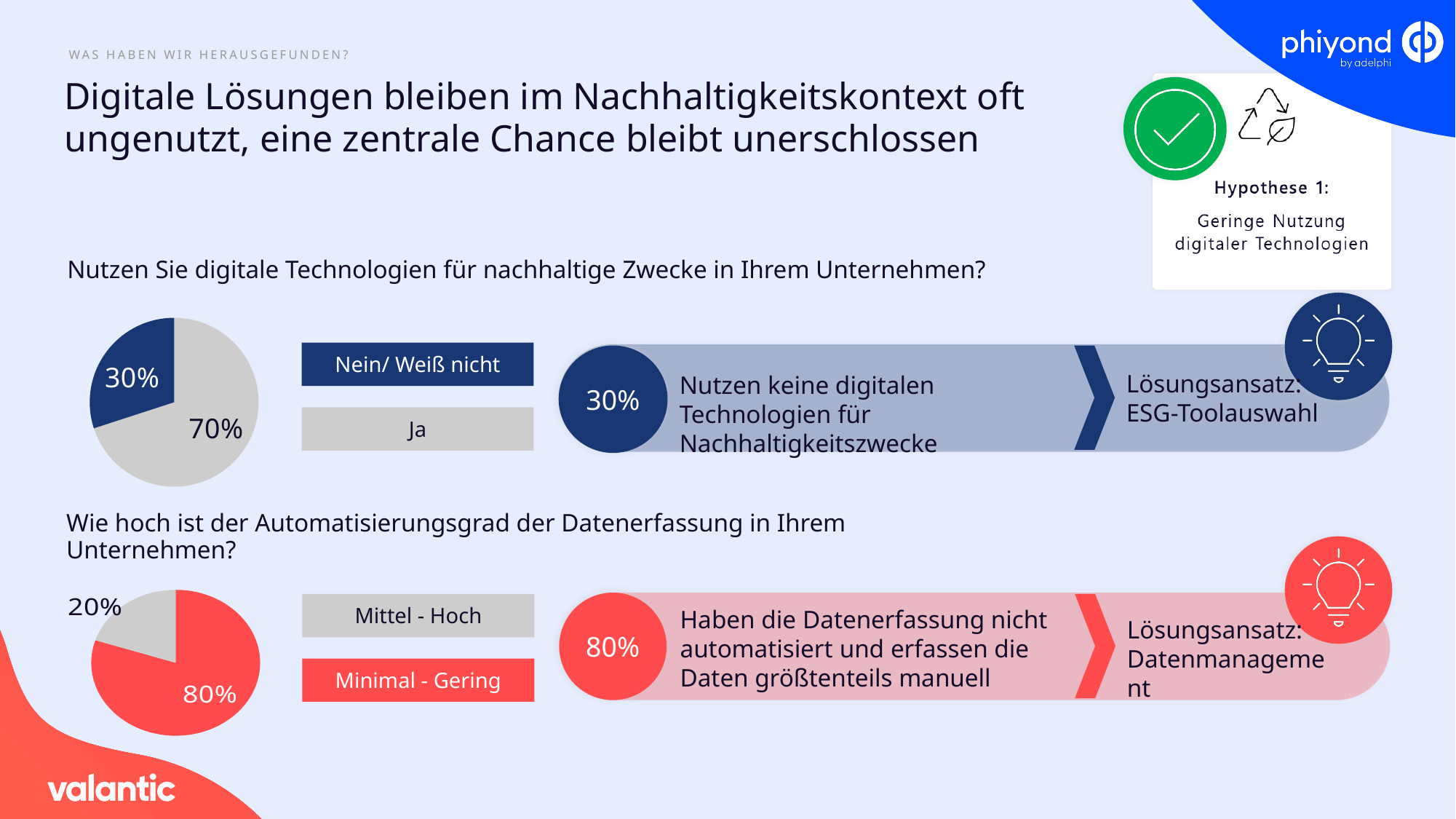
How many slices does the bottom pie chart have? 2 In the bottom pie chart, which is larger: "Minimal - Gering" or "Mittel - Hoch"? Minimal - Gering In the bottom pie chart (degree of automation of data collection), what share is labelled "Minimal - Gering"? 80% In the bottom pie chart, what is the difference in percentage points between "Minimal - Gering" and "Mittel - Hoch"? 60 percentage points In the top pie chart, which category has the largest slice? Ja In the top pie chart (digital technologies for sustainability purposes), what share is labelled "Nein/ Weiß nicht"? 30% In the bottom pie chart, what colour is the "Minimal - Gering" slice? Red In the top pie chart, what is the difference in percentage points between "Ja" and "Nein/ Weiß nicht"? 40 percentage points In the bottom pie chart, which category has the smallest slice? Mittel - Hoch In the bottom pie chart (degree of automation of data collection), what share is labelled "Mittel - Hoch"? 20% What type of chart is used for the top question about digital technologies? Pie chart In the top pie chart (digital technologies for sustainability purposes), what share is labelled "Ja"? 70%